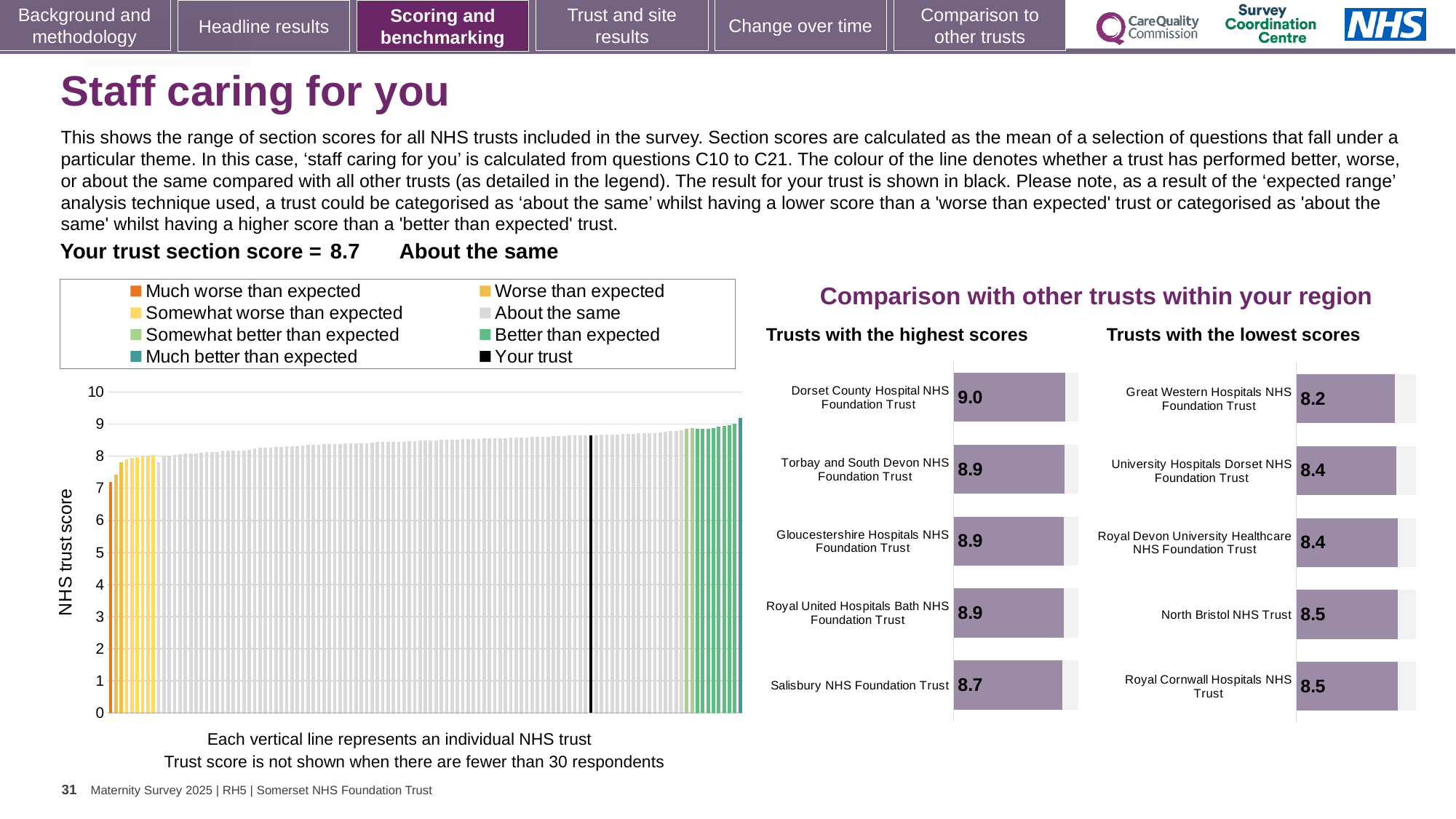
In the 'Trusts with the lowest scores' chart, which trust has the lowest score? Great Western Hospitals NHS Foundation Trust In the large chart on the left showing all NHS trusts, is the value for the lowest (orange) bar greater or less than 8? less In the 'Trusts with the lowest scores' chart, what is the score for Great Western Hospitals NHS Foundation Trust? 8.2 In the 'Trusts with the highest scores' chart, what is the score for Salisbury NHS Foundation Trust? 8.7 In the 'Trusts with the highest scores' chart, what is the score for Dorset County Hospital NHS Foundation Trust? 9.0 In the large chart on the left showing all NHS trusts, do the bar values rise or fall from left to right along the x axis? rise In the 'Trusts with the highest scores' chart, which trust has the highest score? Dorset County Hospital NHS Foundation Trust In the 'Trusts with the lowest scores' chart, which has the larger score: University Hospitals Dorset NHS Foundation Trust or Royal Cornwall Hospitals NHS Trust? Royal Cornwall Hospitals NHS Trust In the 'Trusts with the highest scores' chart, what is the difference between the scores of Dorset County Hospital NHS Foundation Trust and Salisbury NHS Foundation Trust? 0.3 In the 'Trusts with the lowest scores' chart, what is the score for North Bristol NHS Trust? 8.5 How many entries does the legend of the large chart on the left list? 8 How many trusts are shown in the 'Trusts with the lowest scores' chart? 5